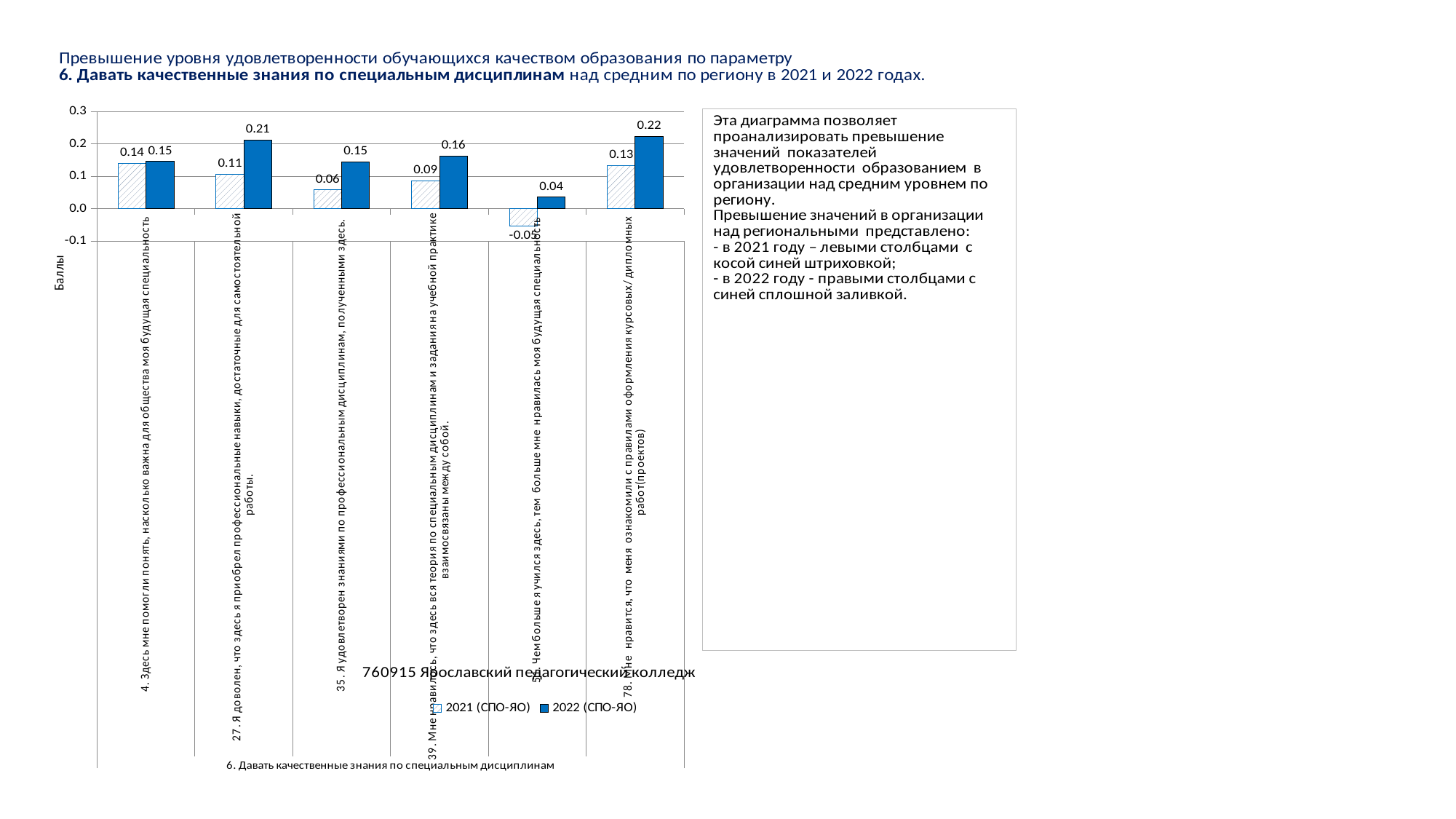
Which statement has the lowest 2021 (СПО-ЯО) value? the fifth statement ("Чем больше я учился здесь, тем больше мне нравилась моя будущая специальность") What is the 2021 (СПО-ЯО) value for statement 35 ("Я удовлетворен знаниями по профессиональным дисциплинам...")? 0.06 What is the 2022 (СПО-ЯО) value for statement 27 ("Я доволен, что здесь я приобрел профессиональные навыки...")? 0.21 Is the 2022 (СПО-ЯО) value for statement 4 greater or less than 0.2? less How many categories (statements) are plotted on the x axis? 6 How many series does the legend list? 2 What type of chart is shown on the slide? bar chart Which is larger for statement 39: the 2021 (СПО-ЯО) value or the 2022 (СПО-ЯО) value? 2022 (СПО-ЯО) What is the difference between the 2022 and 2021 values for statement 27? 0.10 Which statement has the highest 2022 (СПО-ЯО) value? 78. Мне нравится, что меня ознакомили с правилами оформления курсовых/дипломных работ(проектов) What is the 2022 (СПО-ЯО) value for statement 78 ("Мне нравится, что меня ознакомили с правилами оформления курсовых/дипломных работ")? 0.22 What is the label of the y axis? Баллы